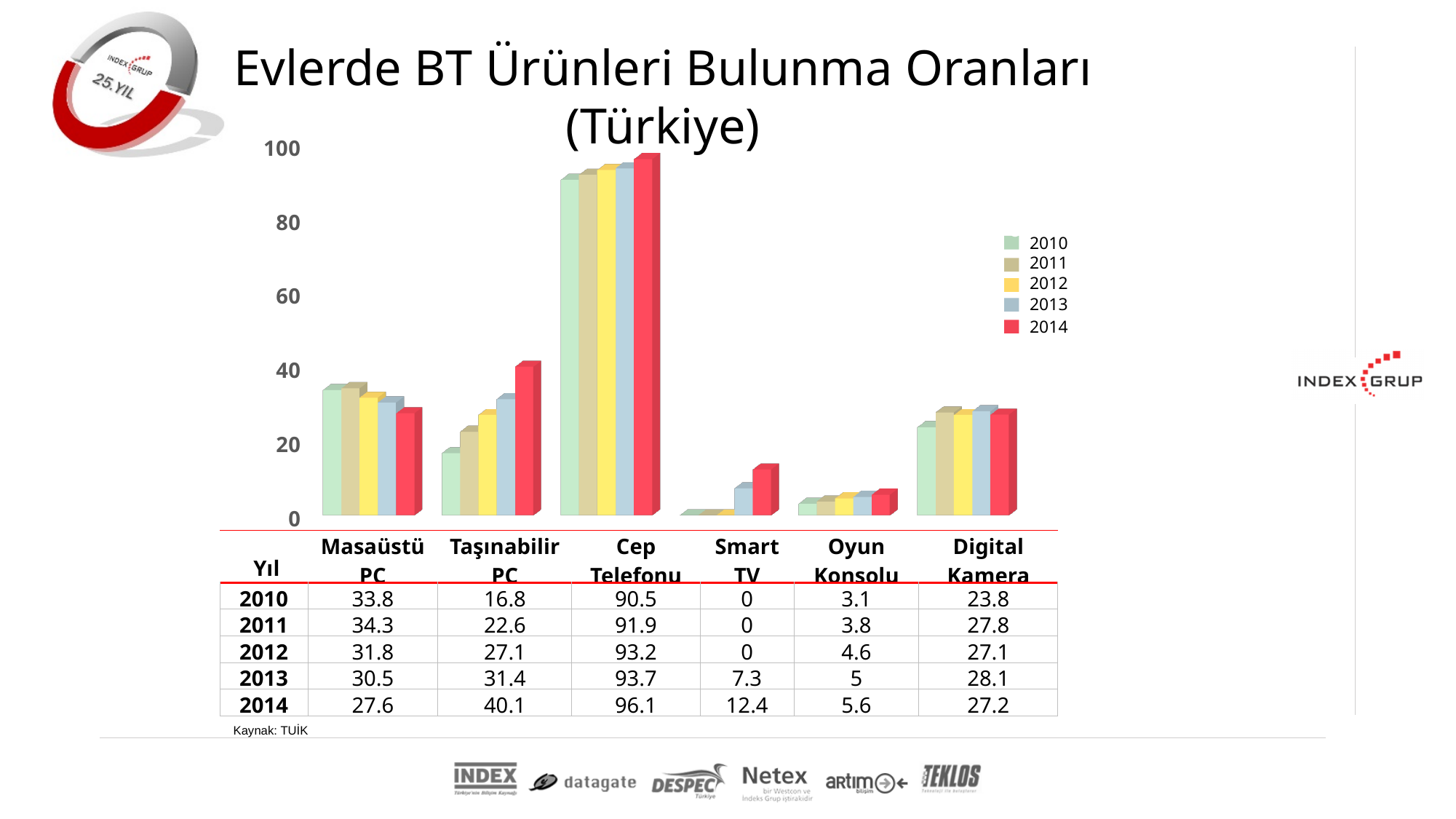
What is the difference between the 2014 and 2010 values for Taşınabilir PC? 23.3 Which category has the lowest value in 2012? Smart TV What is the value for Smart TV in 2013? 7.3 What is the title of the chart? Evlerde BT Ürünleri Bulunma Oranları (Türkiye) How many series does the legend list? 5 Which category has the highest value in 2014? Cep Telefonu What type of chart is shown on the slide? bar chart What is the value for Taşınabilir PC in 2014? 40.1 How many product categories are shown on the x axis? 6 What is the value for Cep Telefonu in 2010? 90.5 Which is larger for 2014: Masaüstü PC or Digital Kamera? Masaüstü PC Do the values for Masaüstü PC rise or fall from 2011 to 2014? fall